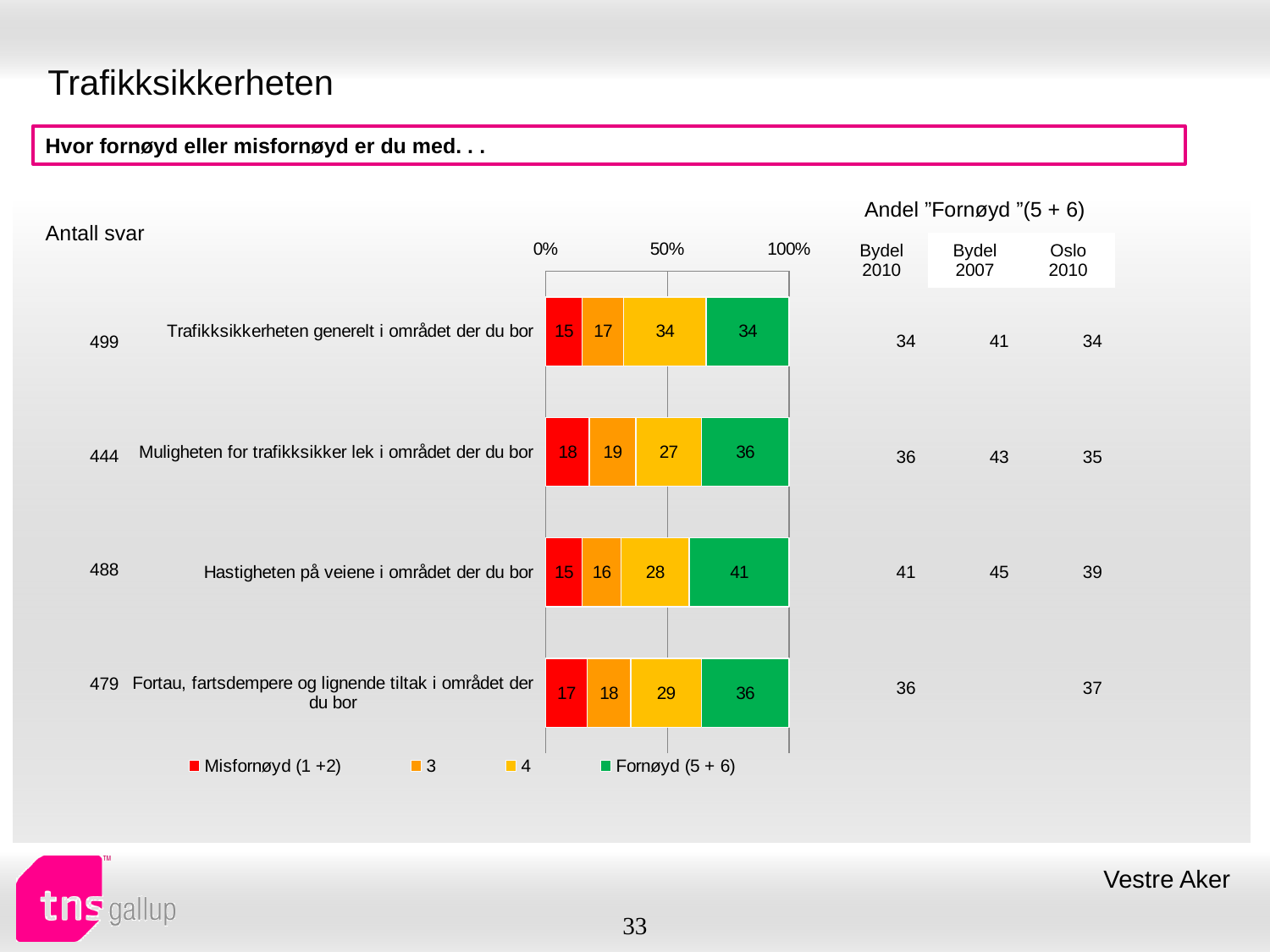
Which category has the lowest "Fornøyd (5 + 6)" value? Trafikksikkerheten generelt i området der du bor How many series does the chart legend list? 4 What is the value of series "4" for "Fortau, fartsdempere og lignende tiltak i området der du bor"? 29 Which category has the highest "Fornøyd (5 + 6)" value? Hastigheten på veiene i området der du bor What kind of chart is shown on the slide? Stacked bar chart What is the value of "Misfornøyd (1 +2)" for "Muligheten for trafikksikker lek i området der du bor"? 18 What is the difference between the "Fornøyd (5 + 6)" values for "Hastigheten på veiene i området der du bor" and "Trafikksikkerheten generelt i området der du bor"? 7 What is the total of the stacked bar for "Trafikksikkerheten generelt i området der du bor"? 100 What is the value of "Fornøyd (5 + 6)" for "Hastigheten på veiene i området der du bor"? 41 How many categories (questions) are plotted in the chart? 4 What is the label of the green series in the legend? Fornøyd (5 + 6) Which is larger: the "Misfornøyd (1 +2)" value for "Muligheten for trafikksikker lek i området der du bor" or for "Hastigheten på veiene i området der du bor"? Muligheten for trafikksikker lek i området der du bor